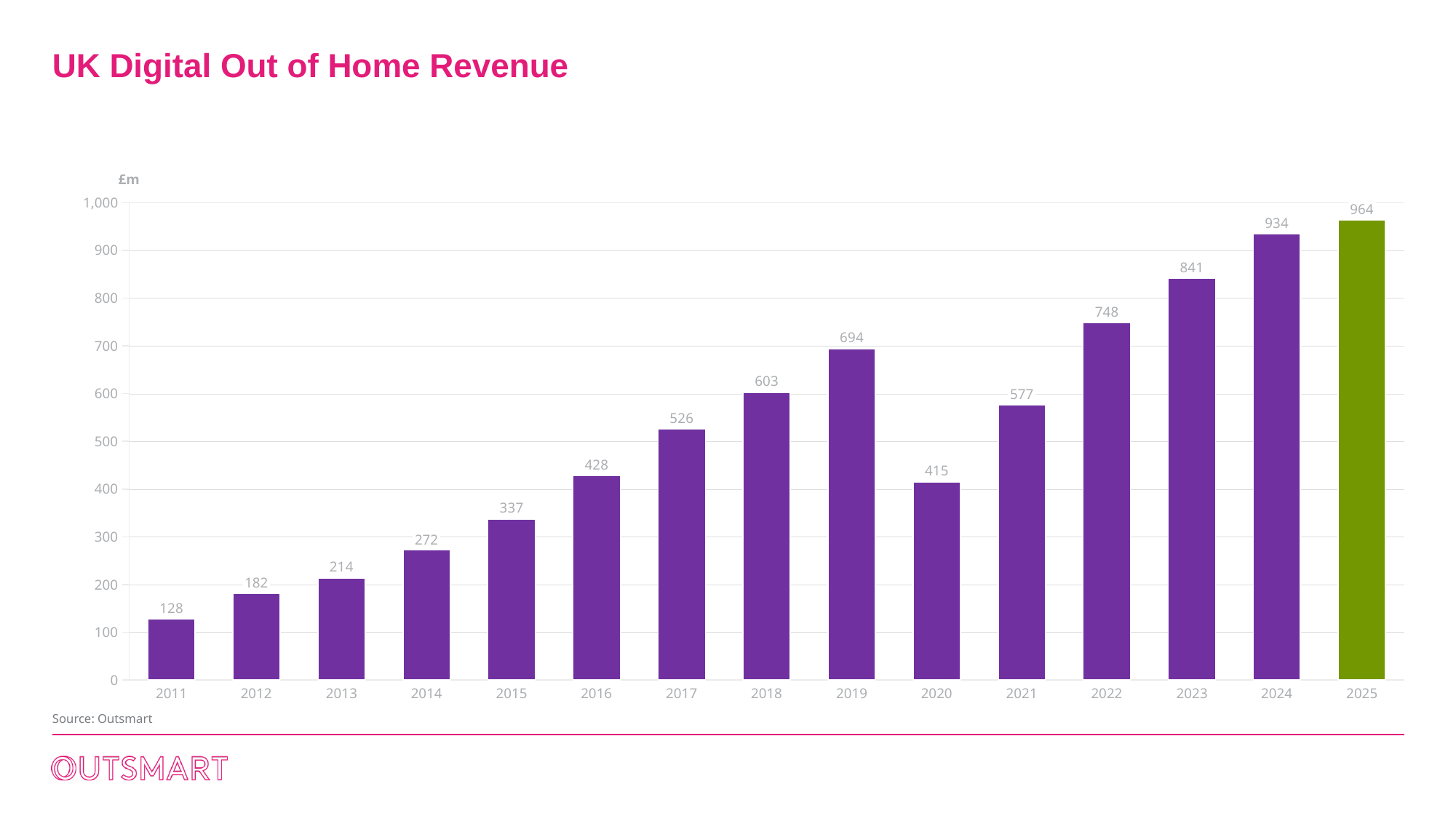
Do the values generally rise or fall from 2011 to 2019? Rise How many years are shown on the x axis? 15 Which year has the lowest revenue? 2011 What is the UK Digital Out of Home revenue for 2019? 694 Is the value for 2016 greater or less than 400? greater Which year's bar is coloured green rather than purple? 2025 What kind of chart is shown on the slide? Bar chart What is the title of the chart? UK Digital Out of Home Revenue Which year has the highest revenue? 2025 Which is larger, the value for 2021 or the value for 2018? 2018 What is the difference between the 2024 and 2023 values? 93 What is the value shown for 2020? 415